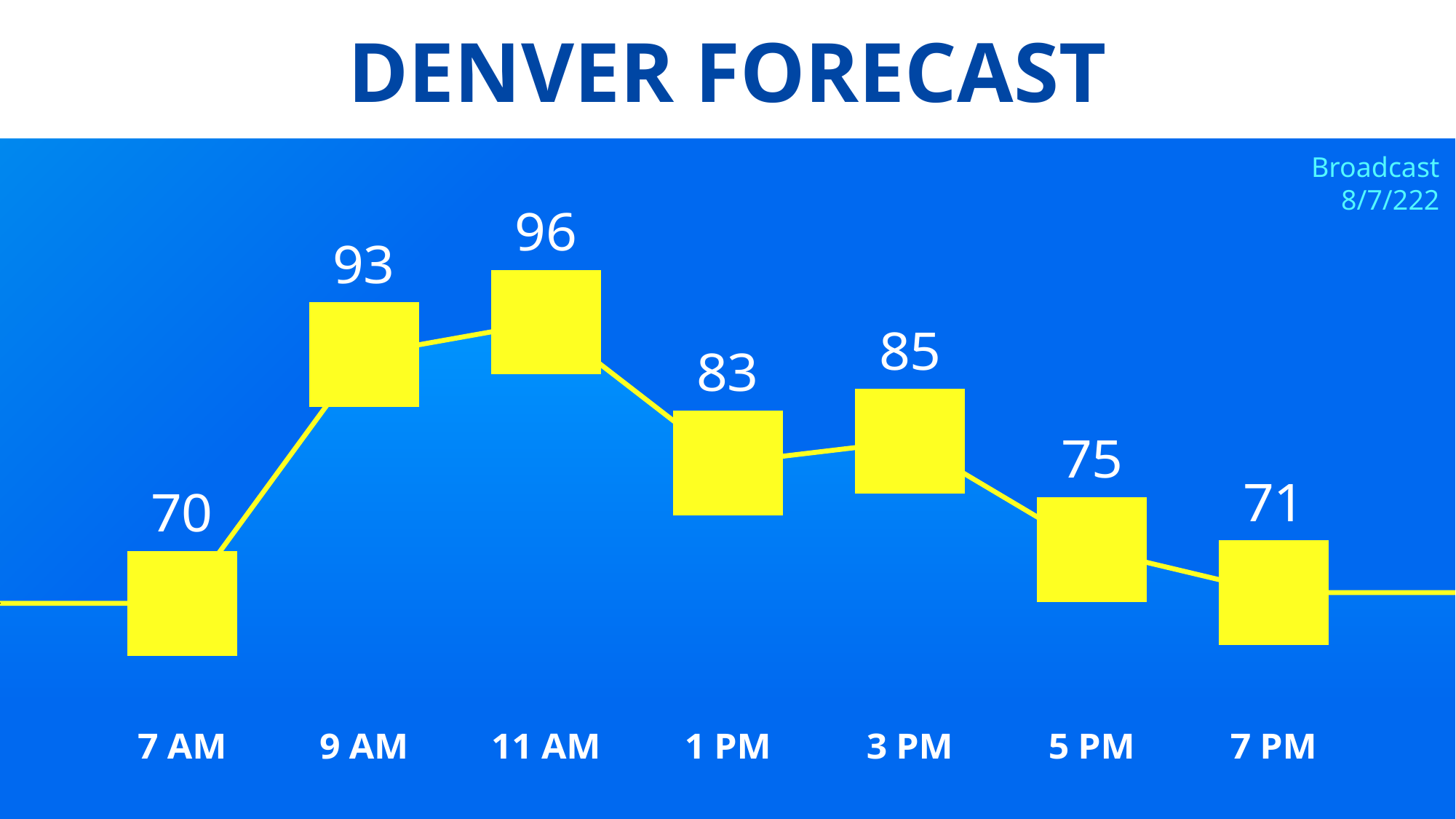
What is the forecast value at 7 AM? 70 What is the title of the chart? DENVER FORECAST What is the difference between the values at 3 PM and 1 PM? 2 What kind of chart is shown on the slide? line chart What is the forecast value at 3 PM? 85 Which is larger, the value at 9 AM or the value at 5 PM? 9 AM At which time is the forecast value highest? 11 AM What is the difference between the values at 11 AM and 7 AM? 26 Do the values rise or fall from 11 AM to 1 PM? fall How many time points are plotted on the chart? 7 At which time is the forecast value lowest? 7 AM What is the forecast value at 11 AM? 96